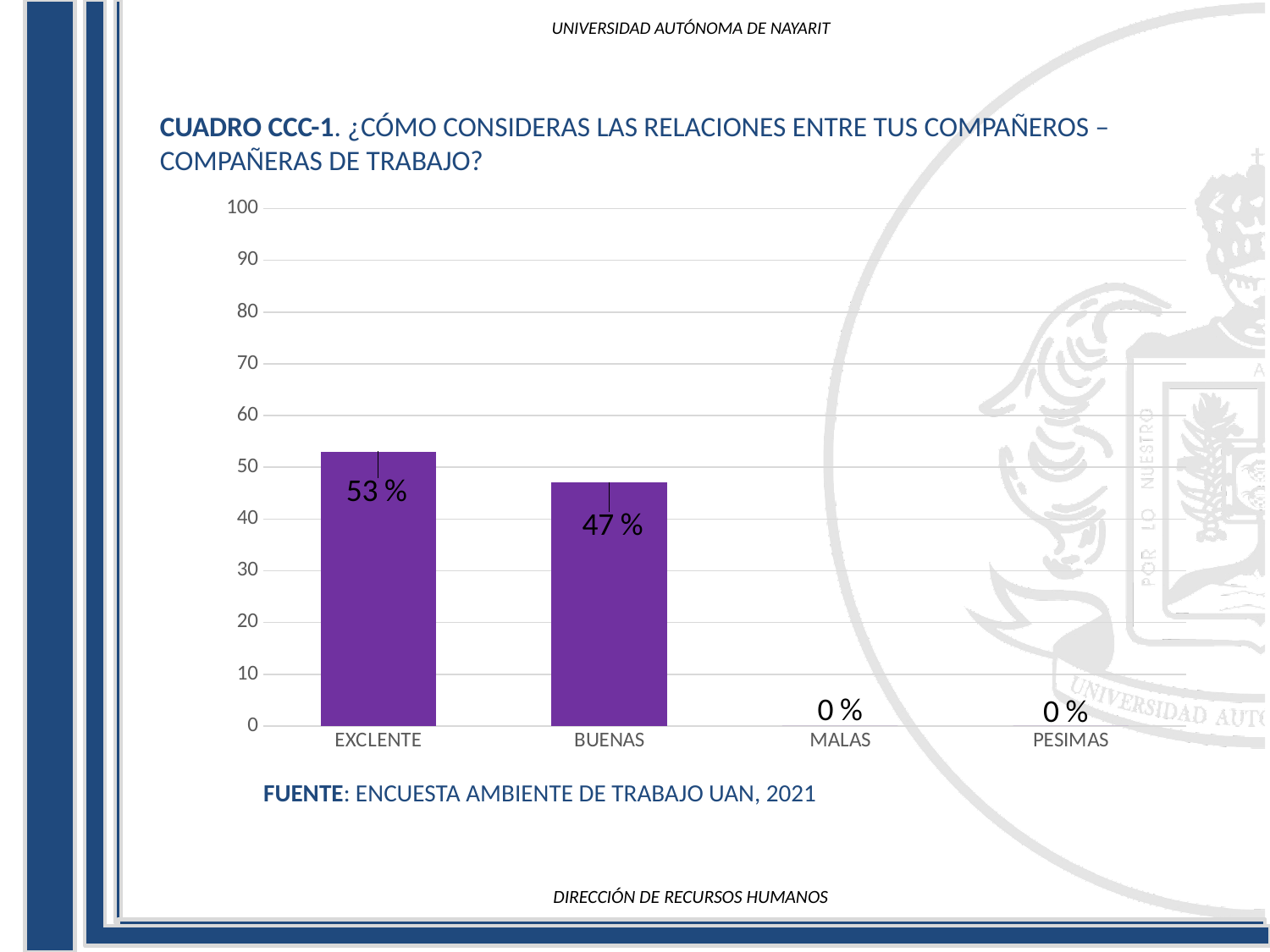
Do the values rise or fall from left to right along the x axis? fall Which category has the highest value? EXCLENTE What kind of chart is shown on the slide? bar chart What source is cited below the chart? ENCUESTA AMBIENTE DE TRABAJO UAN, 2021 What is the value for PESIMAS? 0 % Is the value for BUENAS greater or less than 50? less What is the value for EXCLENTE? 53 % How many categories are shown on the x axis? 4 What is the difference between the values for EXCLENTE and BUENAS? 6 % What is the value for BUENAS? 47 % What is the value for MALAS? 0 % Which is larger, the value for EXCLENTE or the value for BUENAS? EXCLENTE